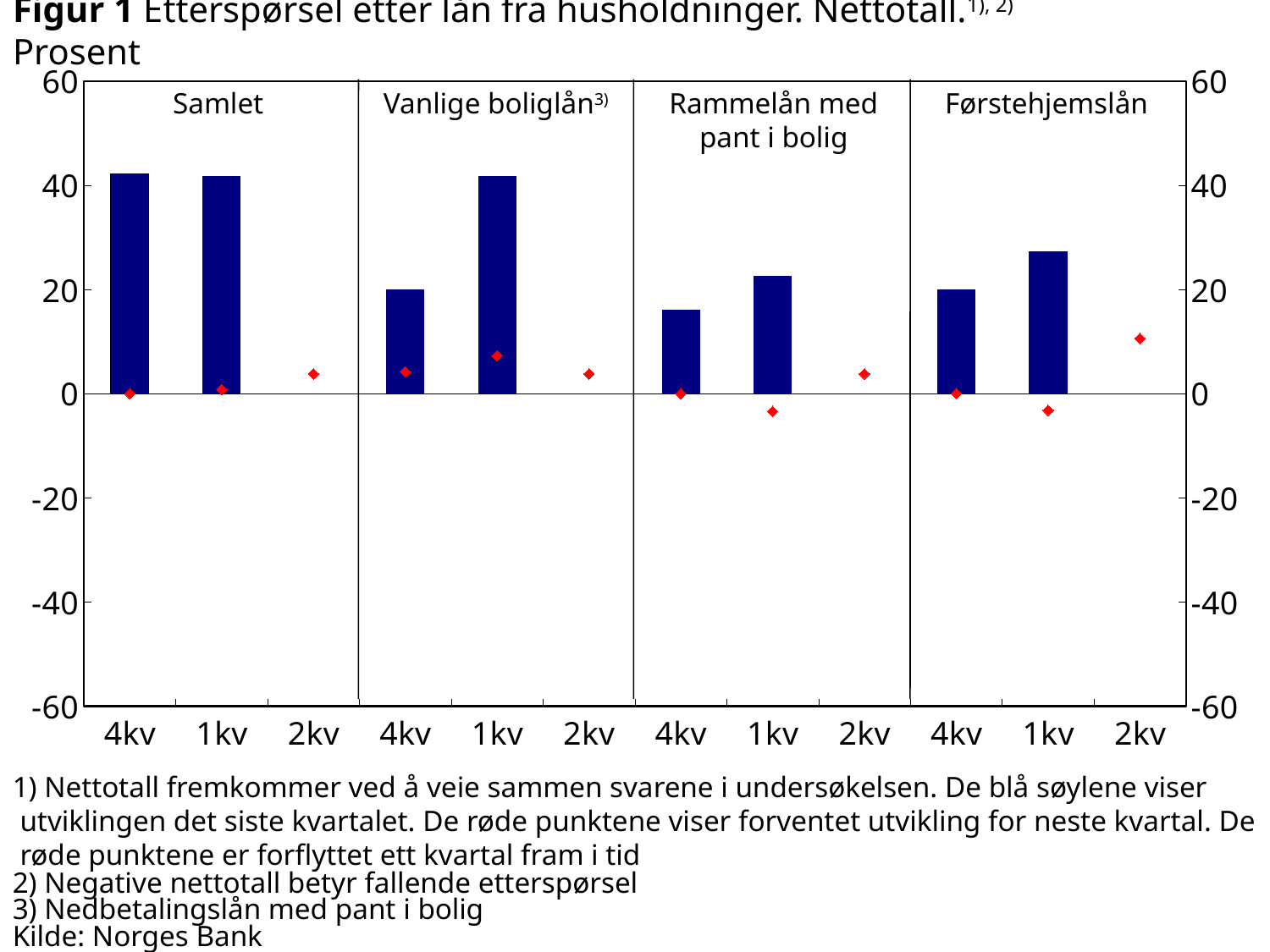
According to the footnote, what do the red points show? Forventet utvikling for neste kvartal In the Førstehjemslån panel, is the bar for 1kv greater or less than 20? greater In the Rammelån med pant i bolig panel, is the bar for 4kv greater or less than 20? less In the Rammelån med pant i bolig panel, do the bars rise or fall from 4kv to 1kv? Rise Which panel has the lowest bar for 4kv? Rammelån med pant i bolig What is the title of the figure? Figur 1 Etterspørsel etter lån fra husholdninger. Nettotall. Prosent In the Rammelån med pant i bolig panel, is the red point for 1kv greater or less than 0? less In the Førstehjemslån panel, which bar is larger, 4kv or 1kv? 1kv How many panels (loan categories) does the chart have? 4 In the Vanlige boliglån panel, which bar is larger, 4kv or 1kv? 1kv What kind of chart is shown on the slide? Bar chart